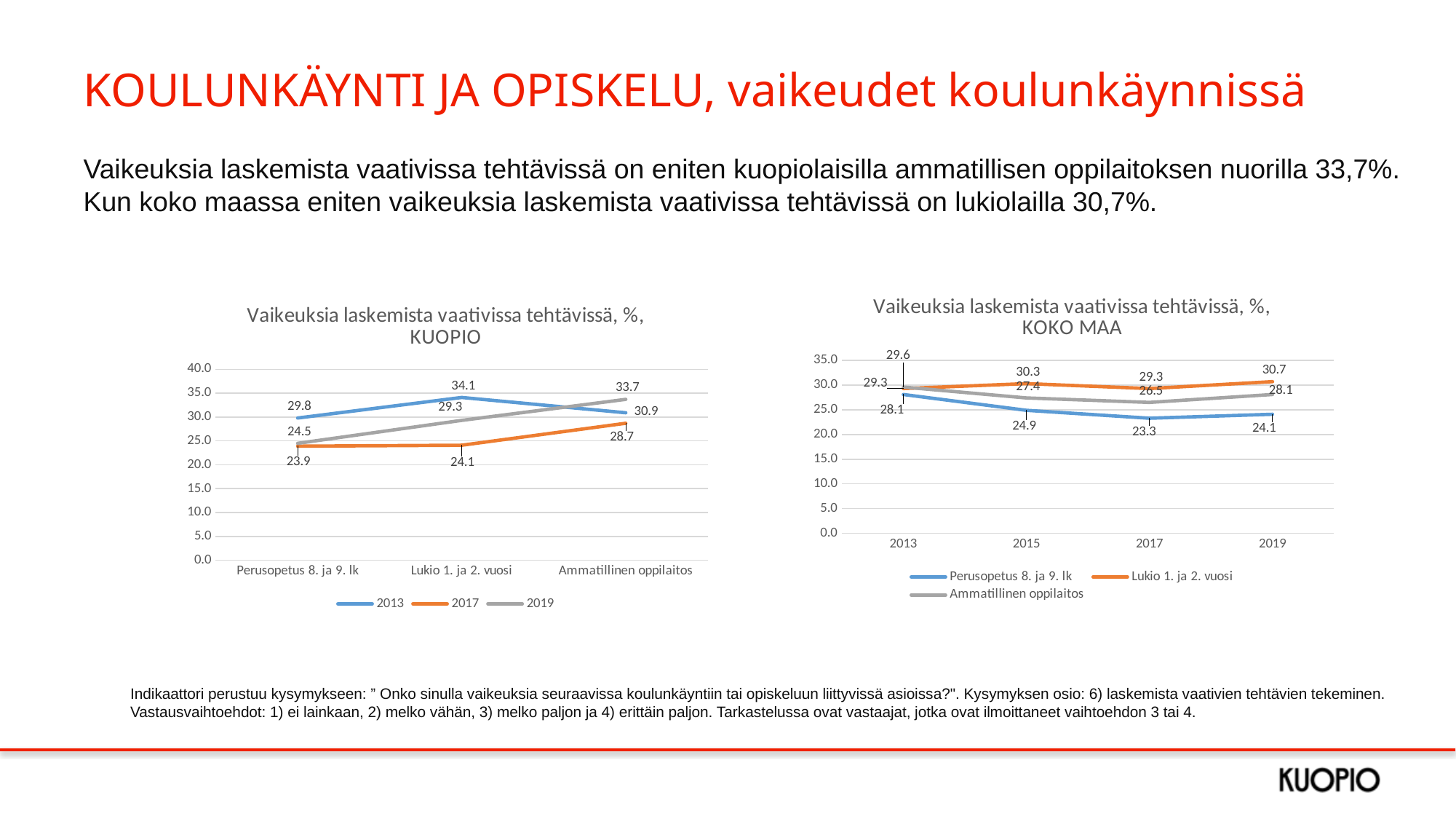
In the KOKO MAA chart, is the 2015 value for Ammatillinen oppilaitos larger or smaller than the 2015 value for Lukio 1. ja 2. vuosi? Smaller In the KOKO MAA chart, what is the 2019 value for Lukio 1. ja 2. vuosi? 30.7 In the KOKO MAA chart, what is the 2017 value for Perusopetus 8. ja 9. lk? 23.3 In the KUOPIO chart, what is the difference between the 2013 and 2017 values for Lukio 1. ja 2. vuosi? 10.0 In the KUOPIO chart, what is the 2019 value for Ammatillinen oppilaitos? 33.7 In the KOKO MAA chart, how many years are shown on the x axis? 4 In the KOKO MAA chart, which series has the lowest value in 2019? Perusopetus 8. ja 9. lk In the KUOPIO chart, what is the 2017 value for Perusopetus 8. ja 9. lk? 23.9 In the KUOPIO chart, which category has the highest 2019 value? Ammatillinen oppilaitos In the KUOPIO chart, what is the 2013 value for Lukio 1. ja 2. vuosi? 34.1 In the KUOPIO chart, how many series does the legend list? 3 What type of chart is the KUOPIO chart? Line chart